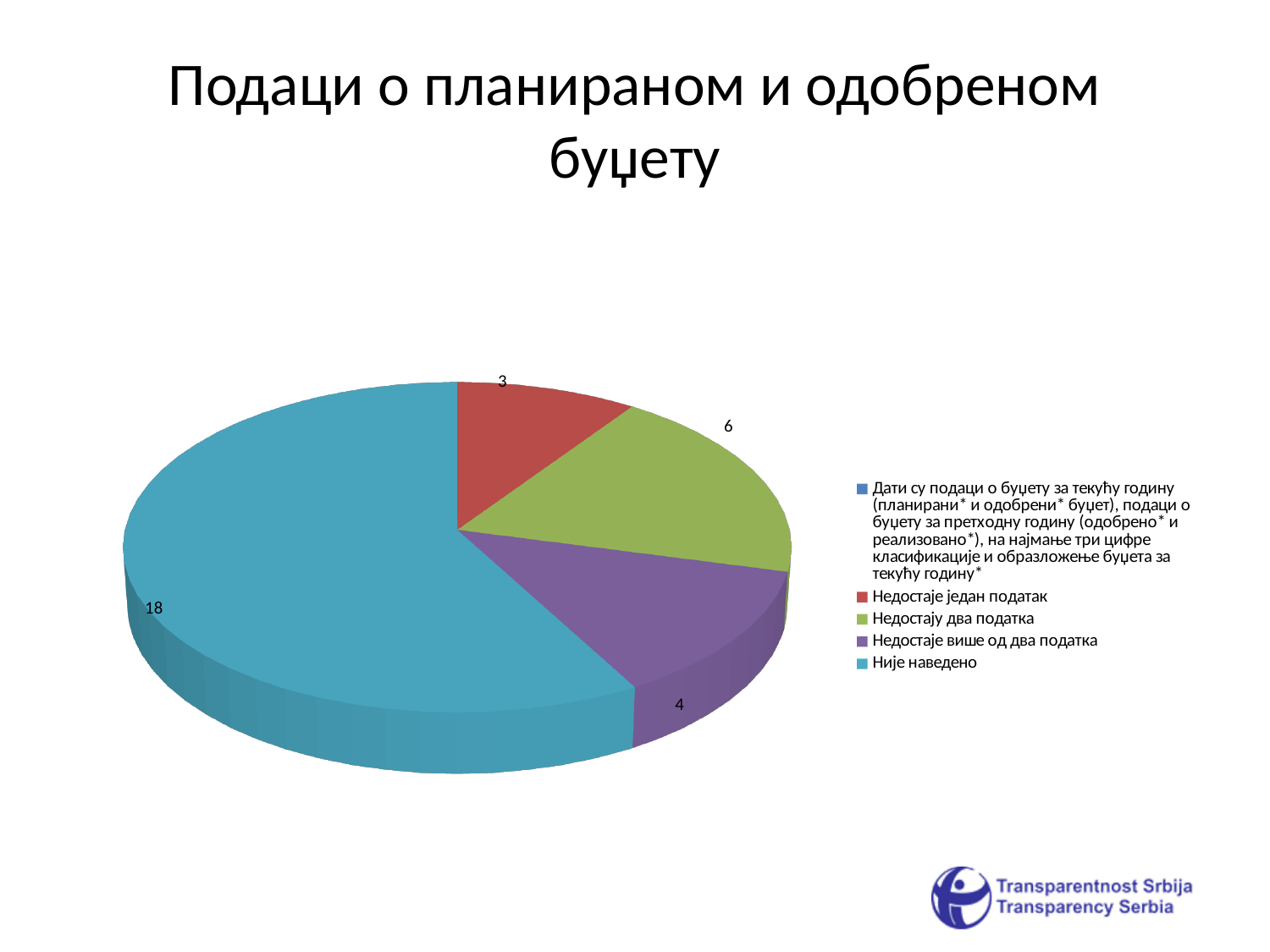
What value is shown for the "Недостаје више од два податка" slice? 4 What colour is the "Није наведено" slice in the pie chart? Light blue What is the difference between the values for "Није наведено" and "Недостаје више од два податка"? 14 What value is shown for the "Није наведено" slice of the pie chart? 18 Of the slices visible in the pie chart, which category has the smallest slice? Недостаје један податак Which is larger: the value for "Недостају два податка" or for "Недостаје више од два податка"? Недостају два податка What value is shown for the "Недостаје један податак" slice? 3 Which category has the largest slice in the pie chart? Није наведено What is the difference between the values for "Недостају два податка" and "Недостаје један податак"? 3 What kind of chart is shown on the slide? Pie chart How many entries does the legend of the pie chart list? 5 What value is shown for the "Недостају два податка" slice? 6